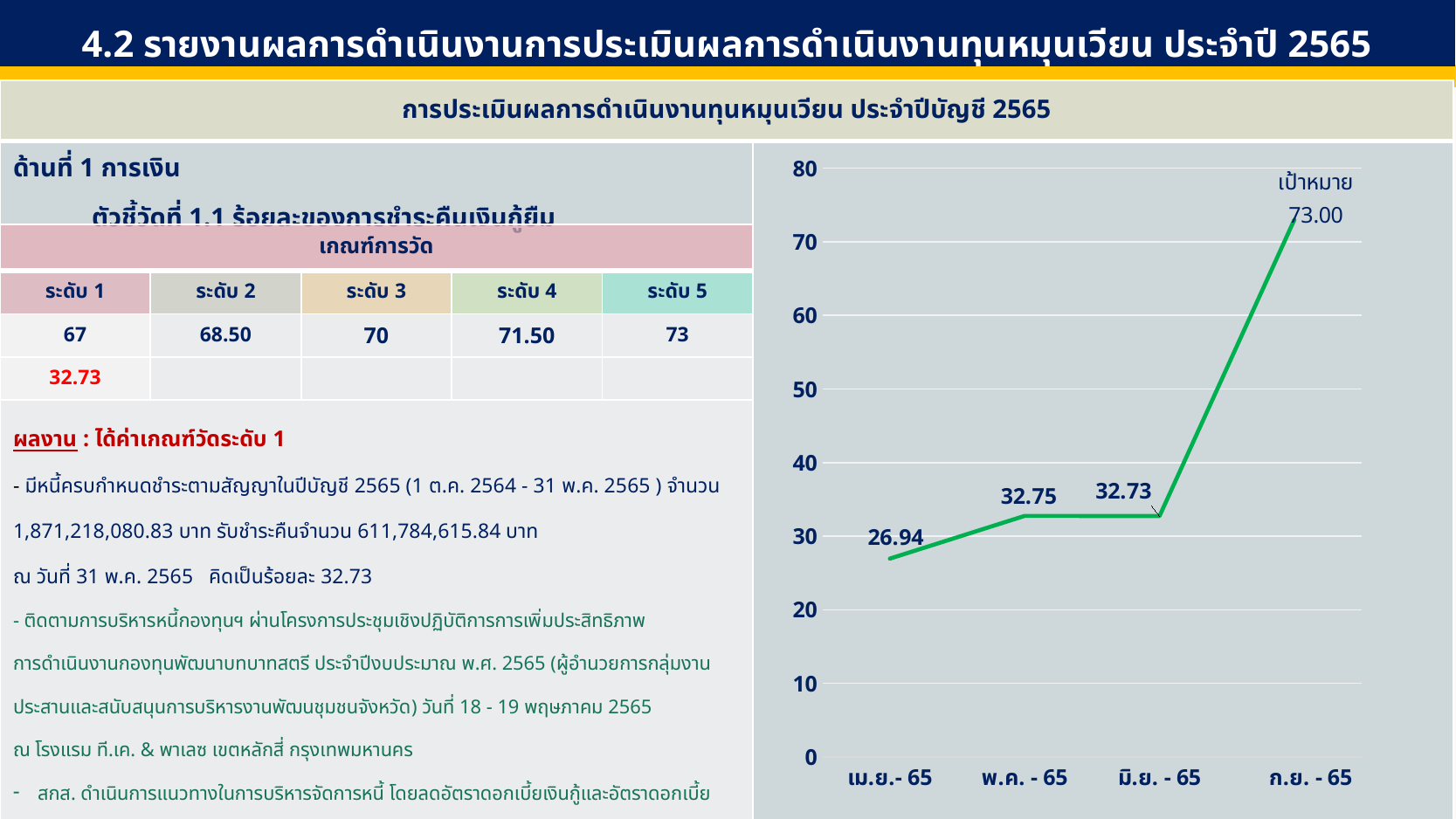
What is the value plotted for ก.ย. - 65? 73.00 What is the difference between the values for พ.ค. - 65 and เม.ย.- 65? 5.81 What is the value plotted for มิ.ย. - 65? 32.73 What is the value plotted for พ.ค. - 65? 32.75 What type of chart is shown on the right side of the slide? line chart Which is larger, the value for ก.ย. - 65 or the value for เม.ย.- 65? ก.ย. - 65 What is the difference between the values for ก.ย. - 65 and มิ.ย. - 65? 40.27 How many data points are plotted on the line chart? 4 Which category has the lowest value on the line chart? เม.ย.- 65 Which category has the highest value on the line chart? ก.ย. - 65 What is the value plotted for เม.ย.- 65? 26.94 What label is written above the last point of the line chart? เป้าหมาย